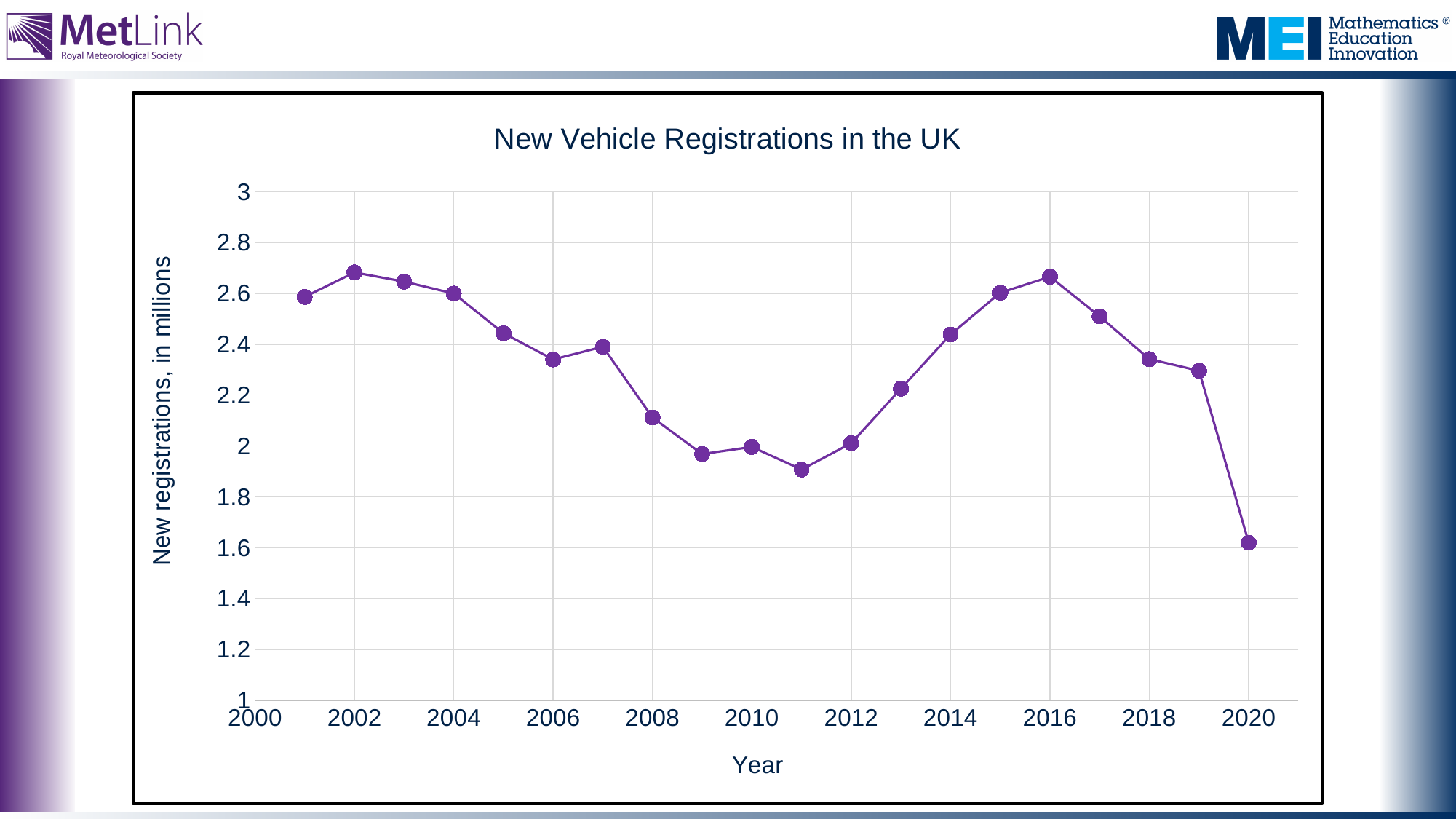
Is the value for 2020 greater or less than 1.8? less Do new vehicle registrations rise or fall between 2016 and 2020? fall Which year has more new vehicle registrations, 2009 or 2014? 2014 How many data points are plotted on the chart? 20 Is the value for 2011 greater or less than 2? less What is the title of the chart? New Vehicle Registrations in the UK What is the label on the vertical axis of the chart? New registrations, in millions Is the value for 2018 greater or less than 2.4? less What kind of chart is shown on the slide? line chart Which year has the lowest number of new vehicle registrations? 2020 Which year has more new vehicle registrations, 2004 or 2008? 2004